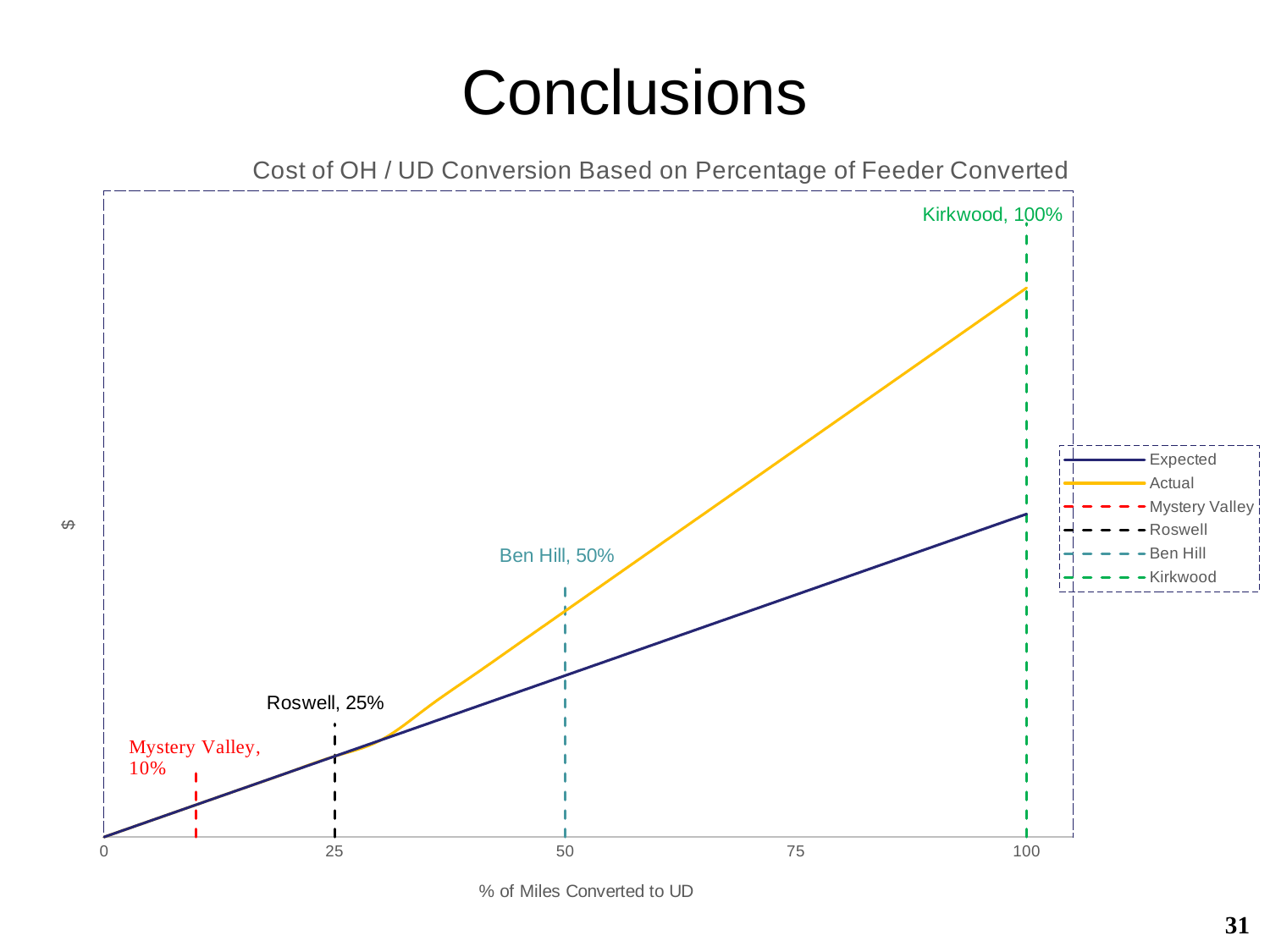
Does the Actual line rise or fall as the percentage of miles converted increases? rise Which feeder is marked at the lowest percentage of miles converted? Mystery Valley What kind of chart is shown on the slide? line chart How many series does the legend list? 6 Which feeder is marked at the highest percentage of miles converted? Kirkwood What is the label of the x axis? % of Miles Converted to UD At what percentage of miles converted is the Ben Hill marker placed? 50% At what percentage of miles converted is the Roswell marker placed? 25% At what percentage of miles converted is the Mystery Valley marker placed? 10% What is the title of the chart? Cost of OH / UD Conversion Based on Percentage of Feeder Converted At what percentage of miles converted is the Kirkwood marker placed? 100% At 100% of miles converted, which line is higher, Actual or Expected? Actual